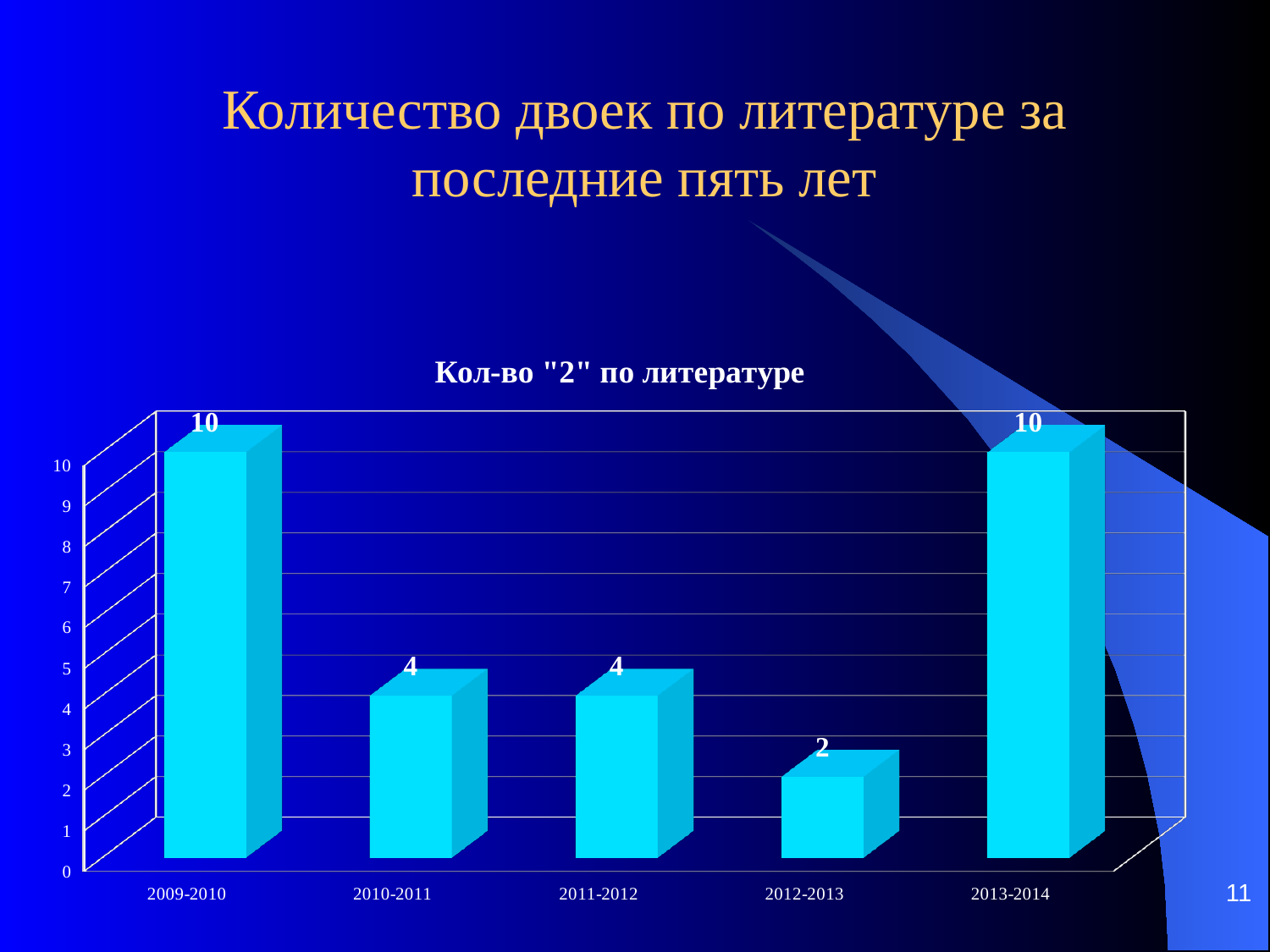
What is the value for 2011-2012? 4 What is the value for 2012-2013? 2 Do the values rise or fall from 2009-2010 to 2012-2013? fall What kind of chart is this? bar chart What is the difference between the values for 2009-2010 and 2012-2013? 8 Is the value for 2010-2011 greater or less than 5? less Which is larger, the value for 2013-2014 or the value for 2011-2012? 2013-2014 What is the difference between the values for 2010-2011 and 2012-2013? 2 Which category has the lowest value? 2012-2013 What is the title of the chart? Кол-во "2" по литературе How many categories are shown on the x axis? 5 What is the value for 2009-2010? 10